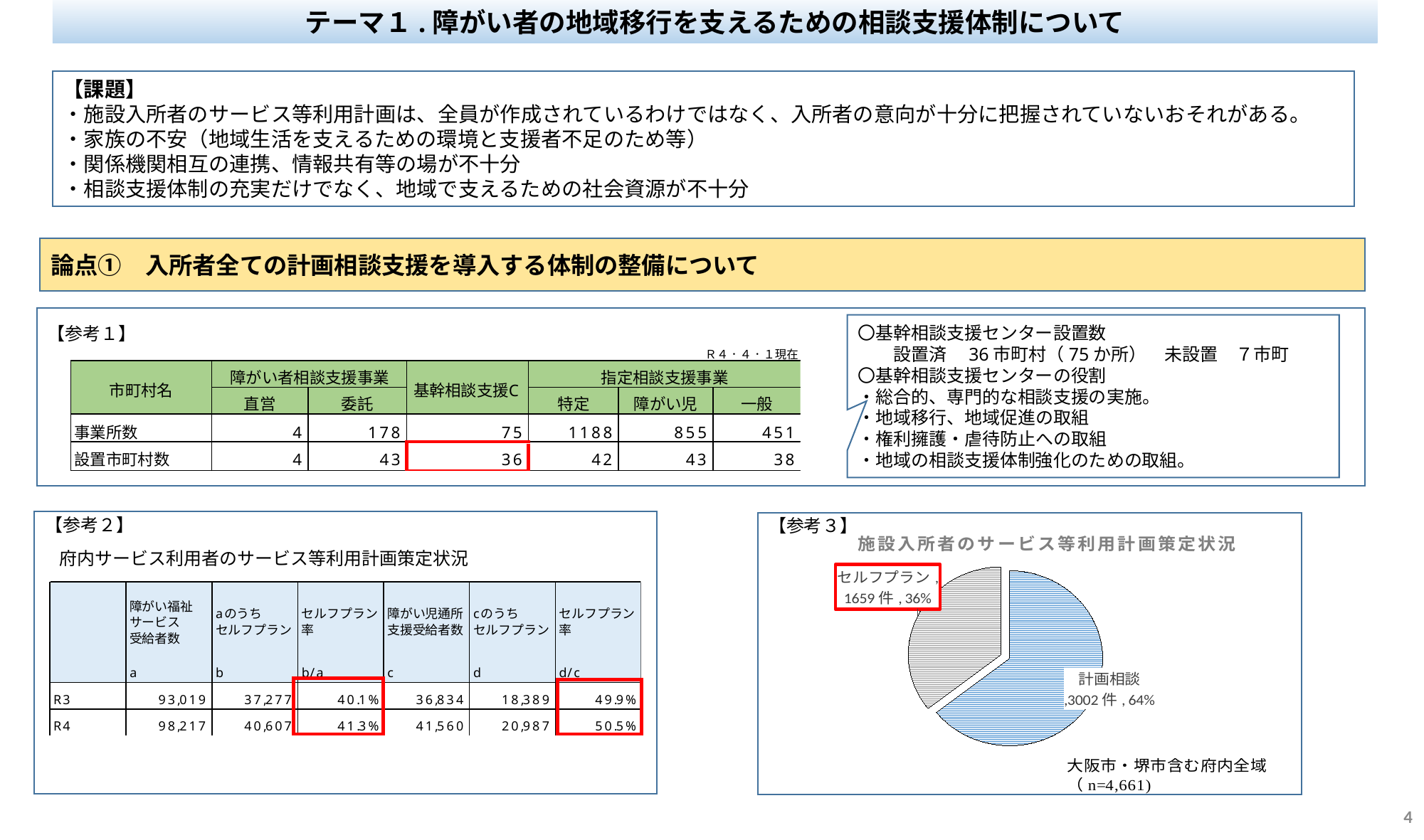
In the pie chart, what is the difference in cases between 計画相談 (3002 件) and セルフプラン (1659 件)? 1343 件 In the pie chart, how many cases (件) are labelled for セルフプラン? 1659 件 In the pie chart, which is larger: the number of cases for 計画相談 or for セルフプラン? 計画相談 In the pie chart, what share of the pie does 計画相談 represent? 64% Which slice of the pie chart is the smallest? セルフプラン What is the total n stated below the pie chart? n=4,661 How many slices does the pie chart have? 2 In the pie chart, how many cases (件) are labelled for 計画相談? 3002 件 In the pie chart, what share of the pie does セルフプラン represent? 36% What kind of chart is shown in 【参考３】? pie chart What is the title of the pie chart in 【参考３】? 施設入所者のサービス等利用計画策定状況 Which slice of the pie chart is the largest? 計画相談